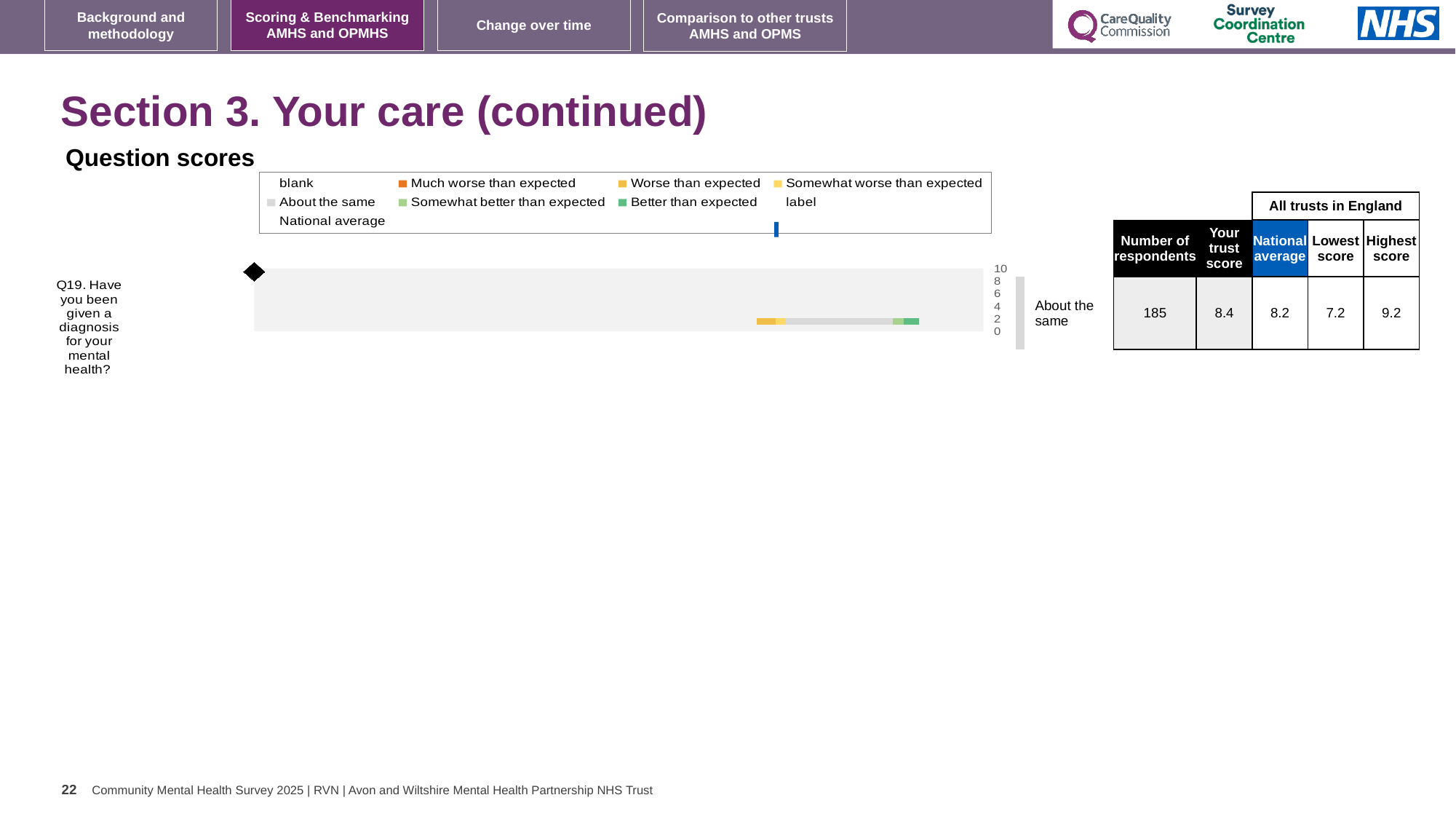
What is the difference between the highest and lowest scores for Q19 across all trusts in England? 2.0 What benchmark category label is shown next to the Q19 bar? About the same What is the national average score for Q19? 8.2 What is the lowest score among all trusts in England for Q19? 7.2 What is the highest score among all trusts in England for Q19? 9.2 By how much does the trust's Q19 score exceed the national average? 0.2 What kind of chart is used to show the Q19 question score? bar chart For Q19, which is larger: the trust's score or the national average? Your trust score What is the trust's score for Q19 (Have you been given a diagnosis for your mental health?)? 8.4 How many survey questions are plotted on the chart? 1 What is the heading shown above the chart? Question scores How many respondents answered Q19? 185